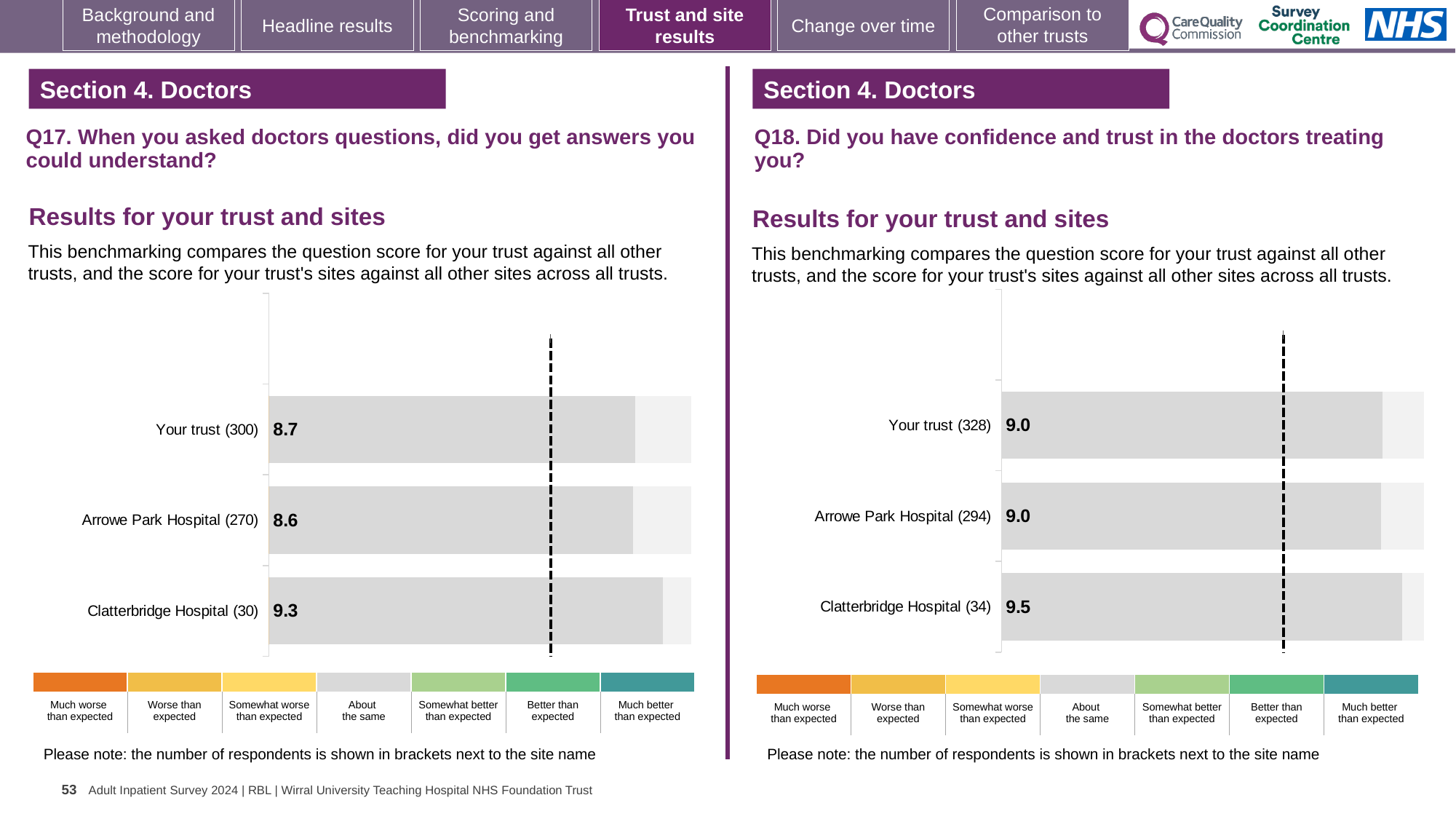
How many bars are plotted in the Q18 chart on the right? 3 In the Q17 chart on the left, what is the score for Arrowe Park Hospital (270)? 8.6 In the Q18 chart on the right, what is the score for Your trust (328)? 9.0 In the Q17 chart on the left, what is the difference between the scores for Clatterbridge Hospital (30) and Arrowe Park Hospital (270)? 0.7 What kind of chart is used in the Q17 chart on the left? Bar chart In the Q17 chart on the left, what is the score for Clatterbridge Hospital (30)? 9.3 In the Q18 chart on the right, which site or trust has the highest score? Clatterbridge Hospital (34) In the Q17 chart on the left, what is the score for Your trust (300)? 8.7 In the Q18 chart on the right, what is the difference between the scores for Clatterbridge Hospital (34) and Arrowe Park Hospital (294)? 0.5 In the Q17 chart on the left, which site or trust has the highest score? Clatterbridge Hospital (30) In the Q18 chart on the right, what is the score for Clatterbridge Hospital (34)? 9.5 In the Q17 chart on the left, which site or trust has the lowest score? Arrowe Park Hospital (270)